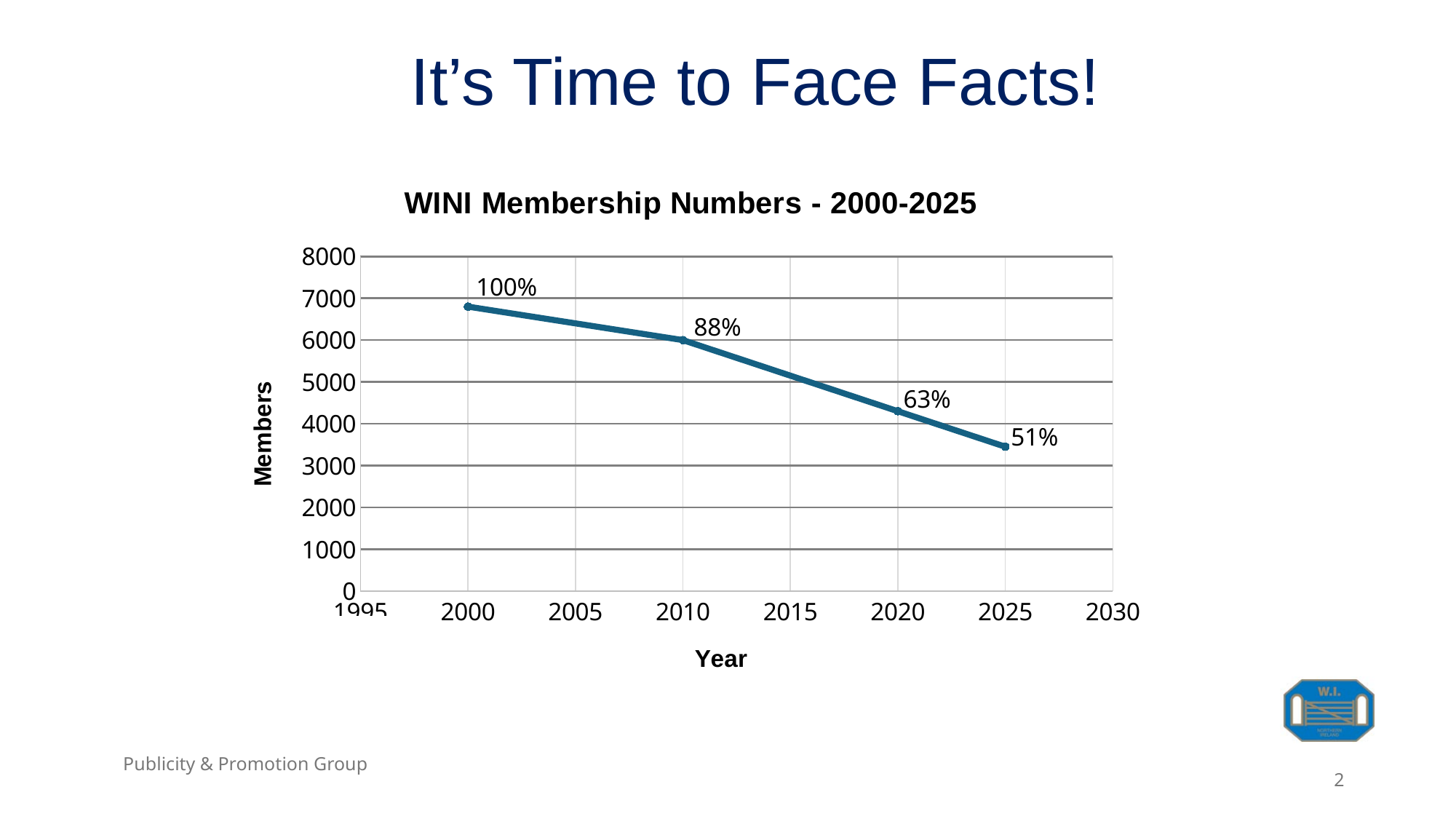
How many data points are plotted on the line? 4 What is the label on the vertical axis? Members Is the number of members in 2000 greater or less than 6000? greater What data label is shown for the year 2010? 88% What data label is shown for the year 2020? 63% What data label is shown for the year 2025? 51% Is the number of members in 2025 greater or less than 4000? less What is the title of the chart? WINI Membership Numbers - 2000-2025 What kind of chart is shown on the slide? line chart Is the number of members in 2020 greater or less than 4000? greater Do the membership numbers rise or fall from 2000 to 2025? fall What data label is shown for the year 2000? 100%